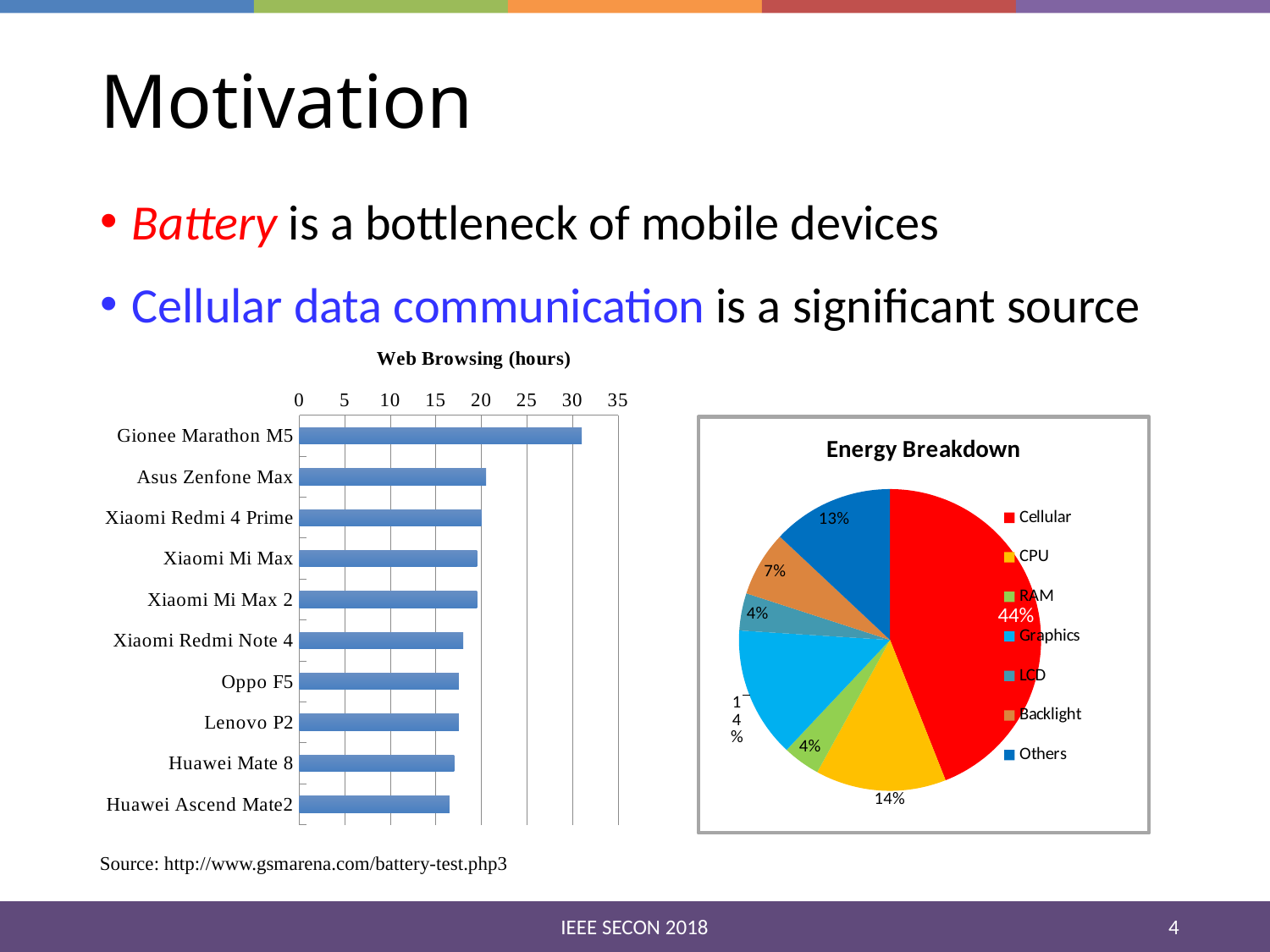
In the Energy Breakdown chart, what is the difference between the Cellular share and the CPU share? 30% In the Energy Breakdown chart, what share does Cellular have? 44% In the Web Browsing (hours) chart, which device has the highest value? Gionee Marathon M5 How many devices are listed in the Web Browsing (hours) chart? 10 In the Energy Breakdown chart, which component has the largest share? Cellular In the Web Browsing (hours) chart, is the value for Gionee Marathon M5 greater or less than 30? greater What kind of chart is the Energy Breakdown chart? pie chart In the Web Browsing (hours) chart, is the value for Xiaomi Redmi Note 4 greater or less than 20? less In the Energy Breakdown chart, what share does Backlight have? 7% What kind of chart is the Web Browsing (hours) chart? bar chart In the Web Browsing (hours) chart, which is larger, the value for Gionee Marathon M5 or Asus Zenfone Max? Gionee Marathon M5 How many entries does the legend of the Energy Breakdown chart list? 7